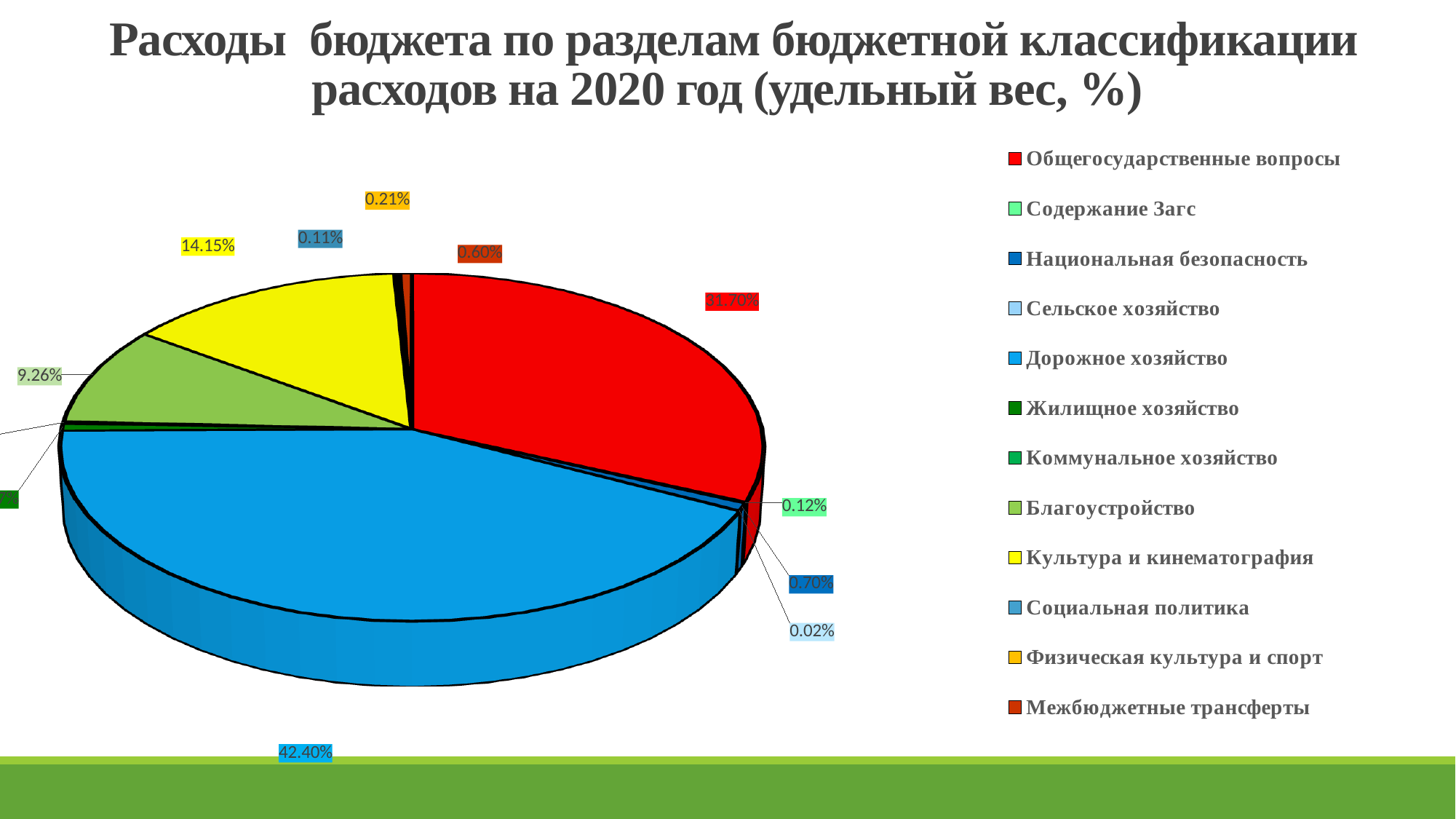
What is the difference in percentage points between the shares of Дорожное хозяйство and Общегосударственные вопросы? 10.70 What share of the budget expenses is Межбюджетные трансферты? 0.60% What kind of chart is shown on the slide? pie chart What share of the budget expenses is Национальная безопасность? 0.70% How many categories does the legend list? 12 What share of the budget expenses is Общегосударственные вопросы? 31.70% What colour is the slice for Общегосударственные вопросы? red Which category has the largest share of the pie? Дорожное хозяйство What share of the budget expenses is Культура и кинематография? 14.15% What share of the budget expenses is Дорожное хозяйство? 42.40% Which has the larger share: Культура и кинематография or Благоустройство? Культура и кинематография What share of the budget expenses is Благоустройство? 9.26%